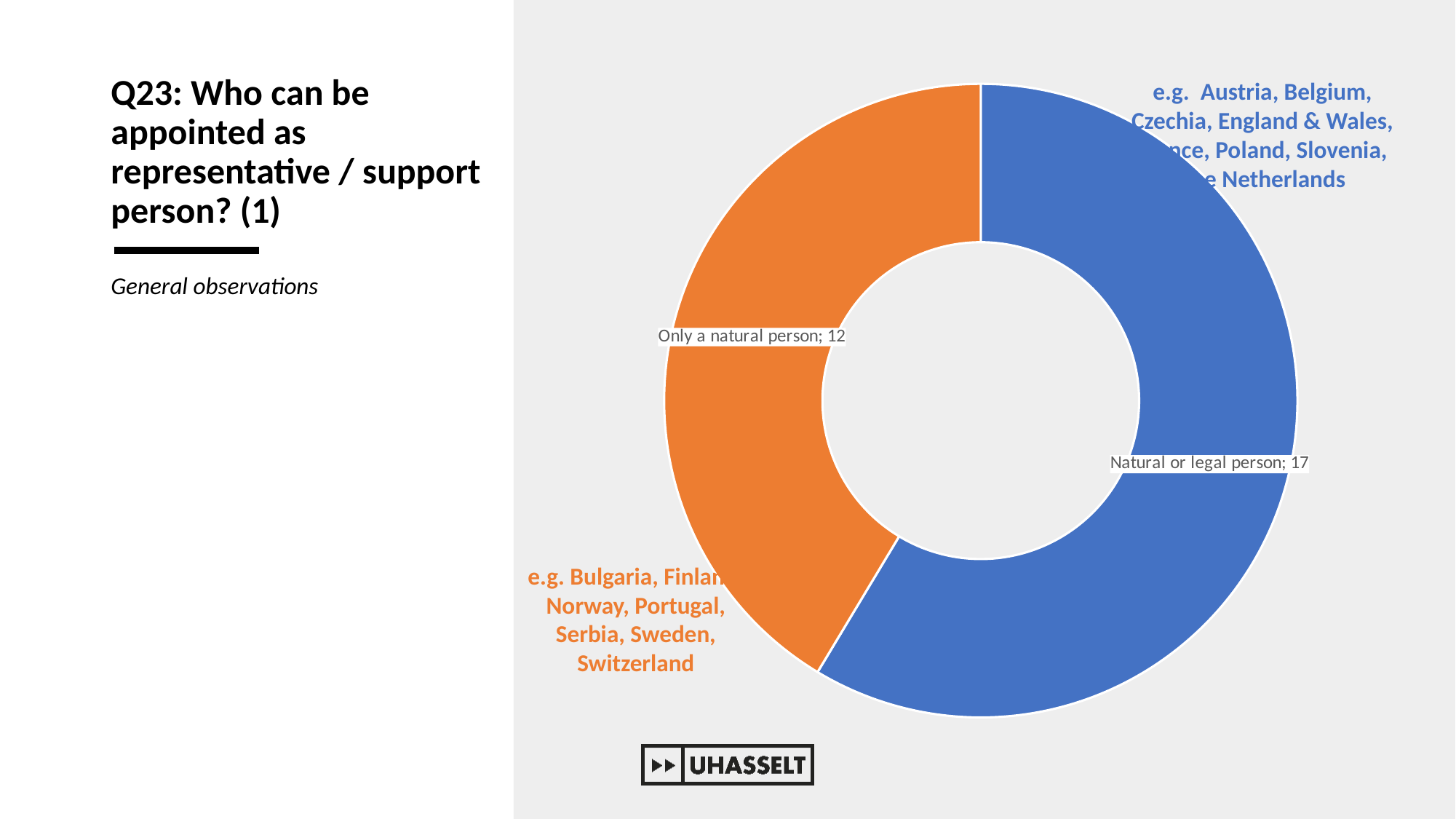
What is the difference between the 'Natural or legal person' value and the 'Only a natural person' value? 5 What is the total of the two slice values? 29 What kind of chart is shown on the slide? doughnut chart What colour is the 'Only a natural person' slice? orange Which category has the larger slice? Natural or legal person Is the value for 'Only a natural person' larger or smaller than the value for 'Natural or legal person'? smaller What colour is the 'Natural or legal person' slice? blue What value is shown for the 'Natural or legal person' slice? 17 What share of the total does the 'Natural or legal person' slice represent, as a fraction? 17 of 29 How many categories does the chart show? 2 What value is shown for the 'Only a natural person' slice? 12 Which category has the smaller slice? Only a natural person